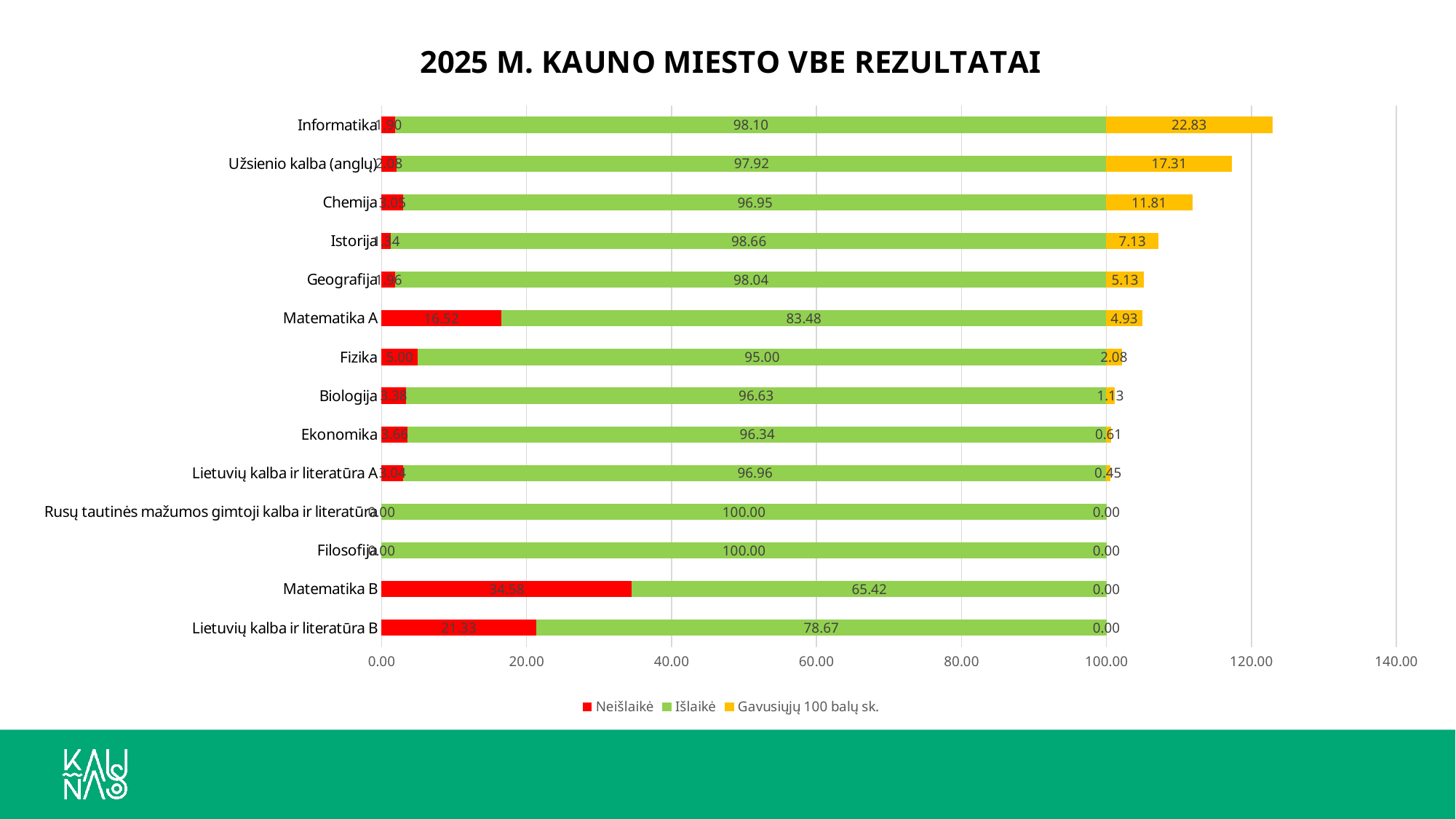
What type of chart is shown on the slide? Stacked bar chart What is the Gavusiųjų 100 balų sk. value for Chemija? 11.81 Which has a larger Gavusiųjų 100 balų sk. value, Užsienio kalba (anglų) or Istorija? Užsienio kalba (anglų) What is the difference between the Neišlaikė values for Matematika B and Lietuvių kalba ir literatūra B? 13.25 Which category has the lowest Išlaikė value? Matematika B Which category has the highest Gavusiųjų 100 balų sk. value? Informatika What is the total of the stacked bar for Matematika A? 104.93 What is the Neišlaikė value for Matematika B? 34.58 What is the Gavusiųjų 100 balų sk. value for Informatika? 22.83 What is the Išlaikė value for Matematika A? 83.48 How many series does the legend list? 3 How many categories are shown on the chart? 14